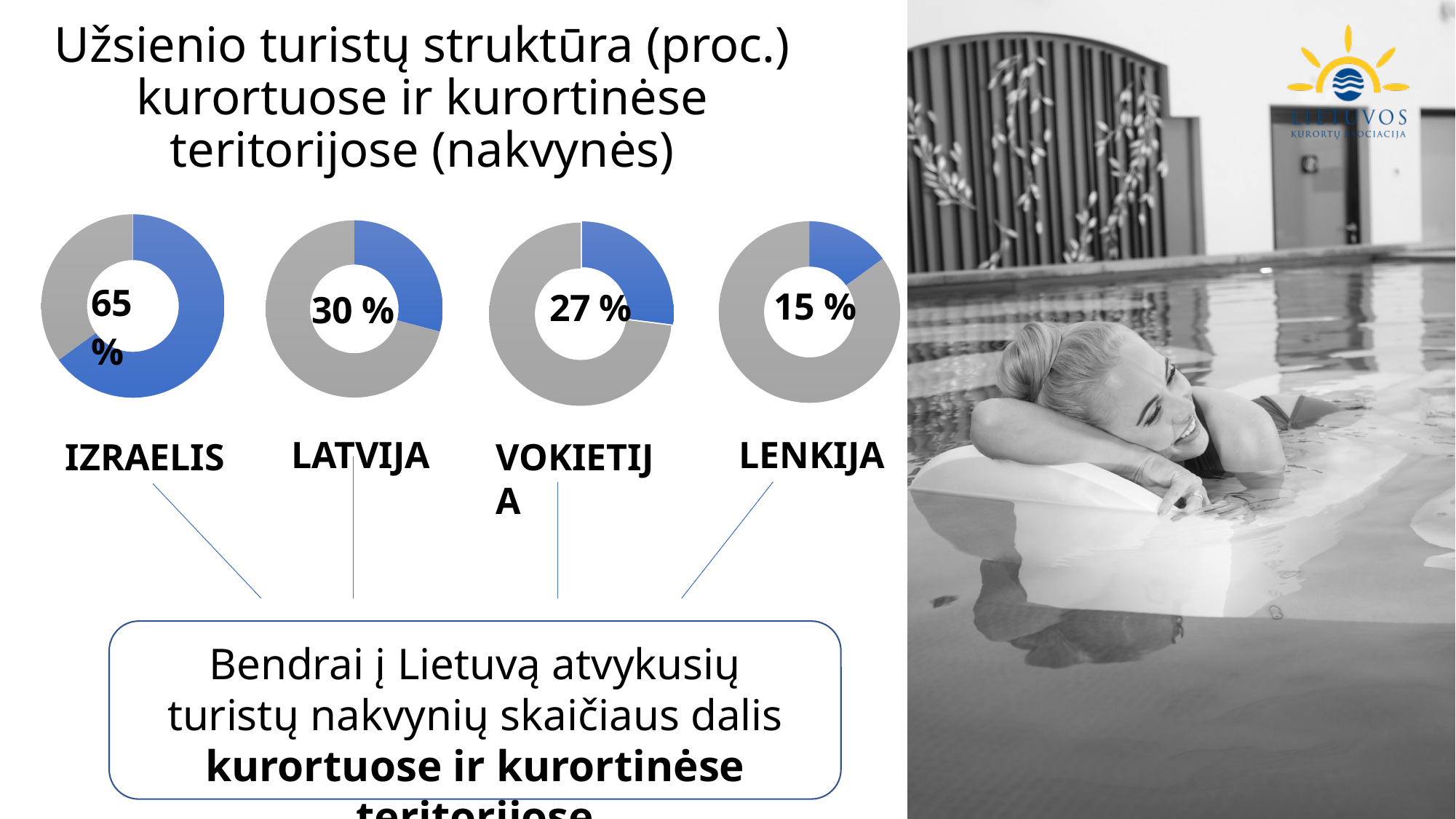
What share is shown in the donut chart for LATVIJA? 30 % What is the difference between the share for IZRAELIS and the share for LENKIJA? 50 % Which is larger, the share for LATVIJA or the share for LENKIJA? LATVIJA How many donut charts are shown on the slide? 4 Which country's donut chart shows the highest share? IZRAELIS What share is shown in the donut chart for IZRAELIS? 65 % What share is shown in the donut chart for VOKIETIJA? 27 % What is the difference between the share for LATVIJA and the share for VOKIETIJA? 3 % What share is shown in the donut chart for LENKIJA? 15 % What kind of chart is used to show each country's share? Donut chart Which country's donut chart shows the lowest share? LENKIJA What colour is used for the highlighted share segment in each donut chart? Blue